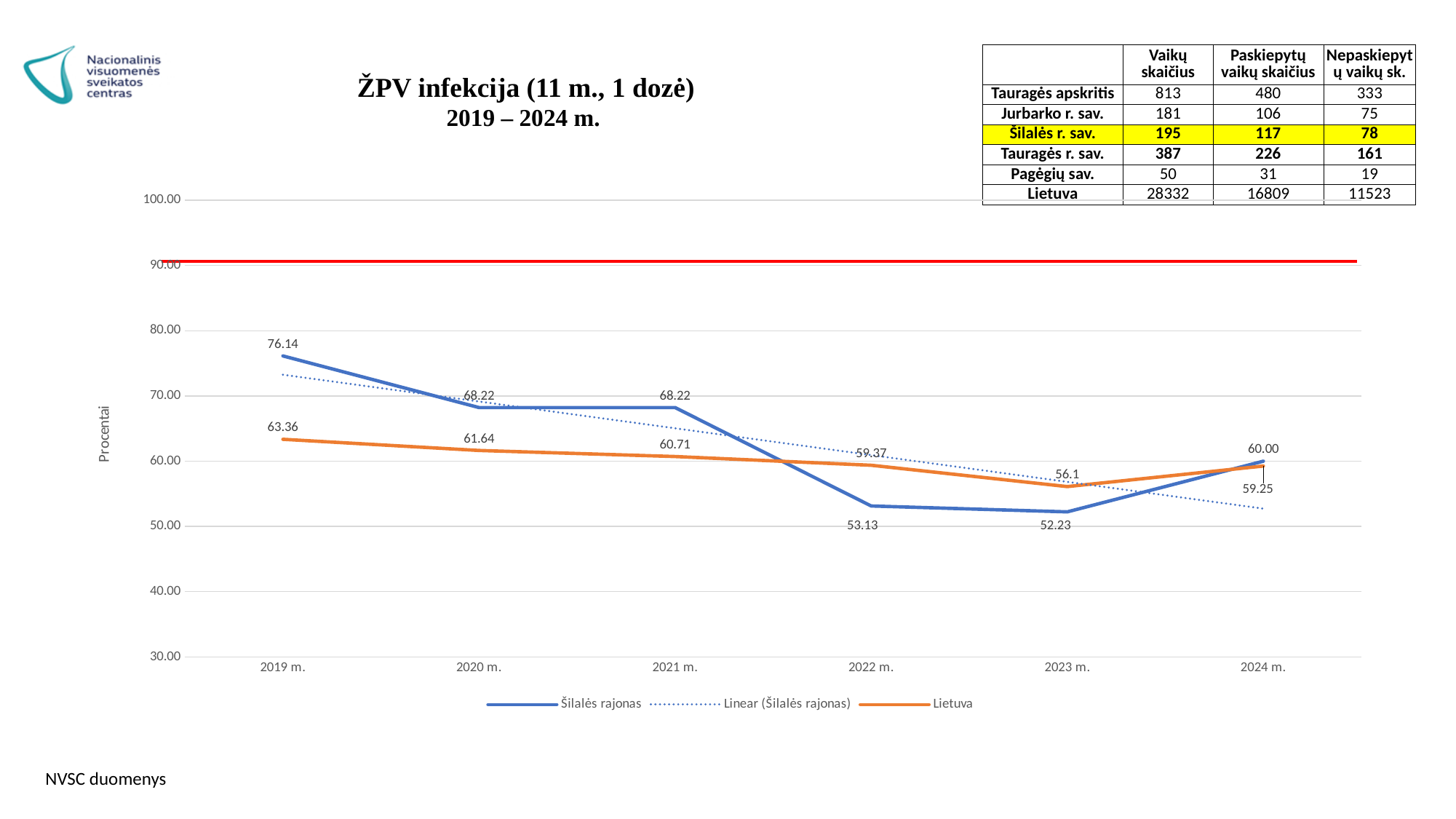
What is the value for Lietuva in 2021 m.? 60.71 Does the Lietuva line rise or fall from 2019 m. to 2023 m.? fall In which year is the Lietuva value highest? 2019 m. What is the value for Šilalės rajonas in 2024 m.? 60.00 What is the difference between the Šilalės rajonas value in 2019 m. and in 2020 m.? 7.92 What type of chart is shown on the slide? line chart What is the value for Šilalės rajonas in 2019 m.? 76.14 In which year is the Šilalės rajonas value lowest? 2023 m. What is the value for Lietuva in 2023 m.? 56.1 How many entries does the legend list? 3 Which is larger in 2022 m., the value for Šilalės rajonas or for Lietuva? Lietuva How many years are shown on the x axis? 6